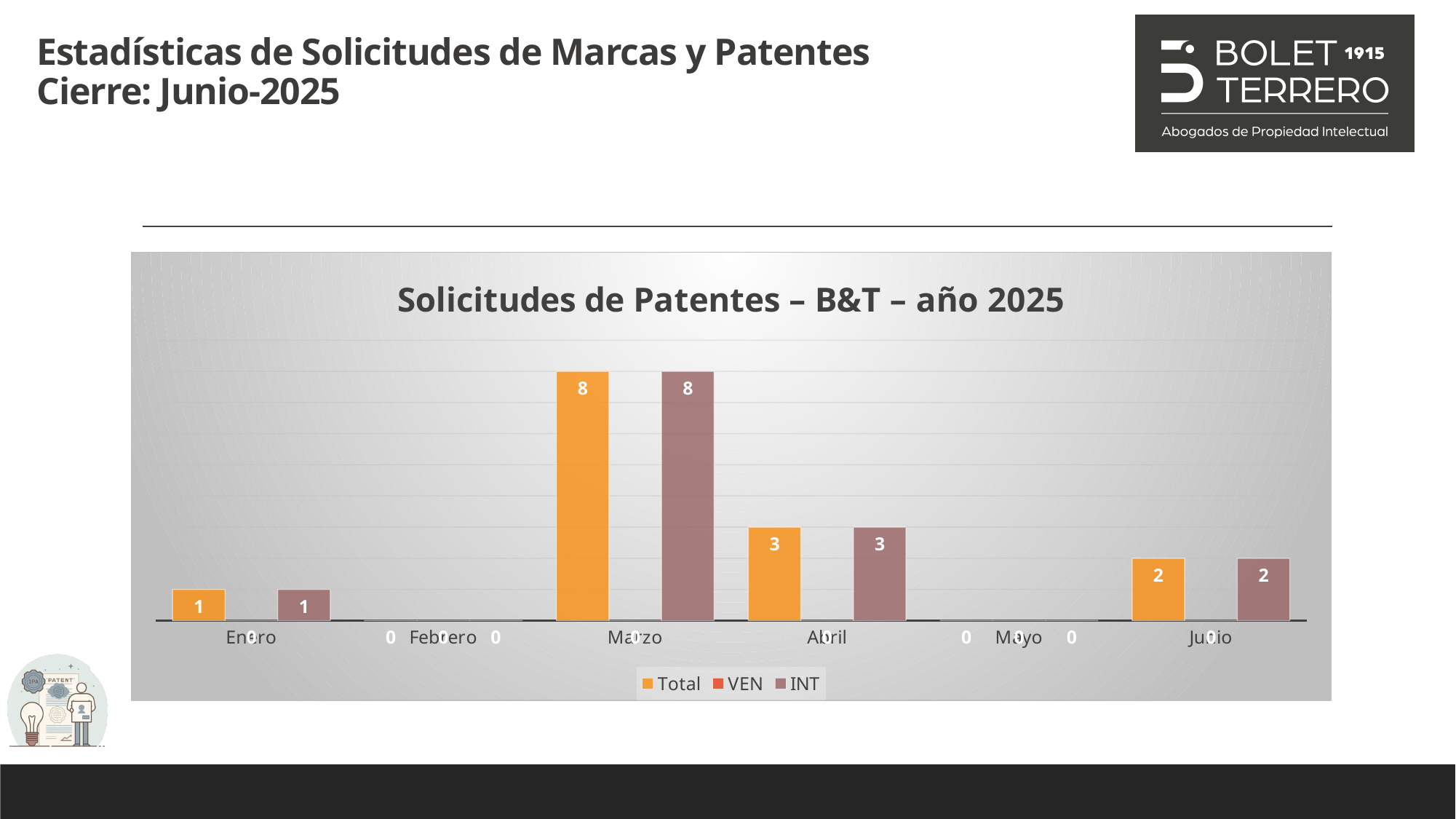
How many months are shown on the x axis? 6 Which series is shown in orange in the legend? Total What is the difference between the Total values for Marzo and Abril? 5 Which is larger, the Total value for Enero or the Total value for Junio? Junio How many series does the legend list? 3 What is the title of the chart? Solicitudes de Patentes – B&T – año 2025 What is the VEN value for Marzo? 0 What is the INT value for Abril? 3 What is the Total value for Marzo? 8 What kind of chart is shown? Bar chart What is the Total value for Junio? 2 Which month has the highest Total value? Marzo